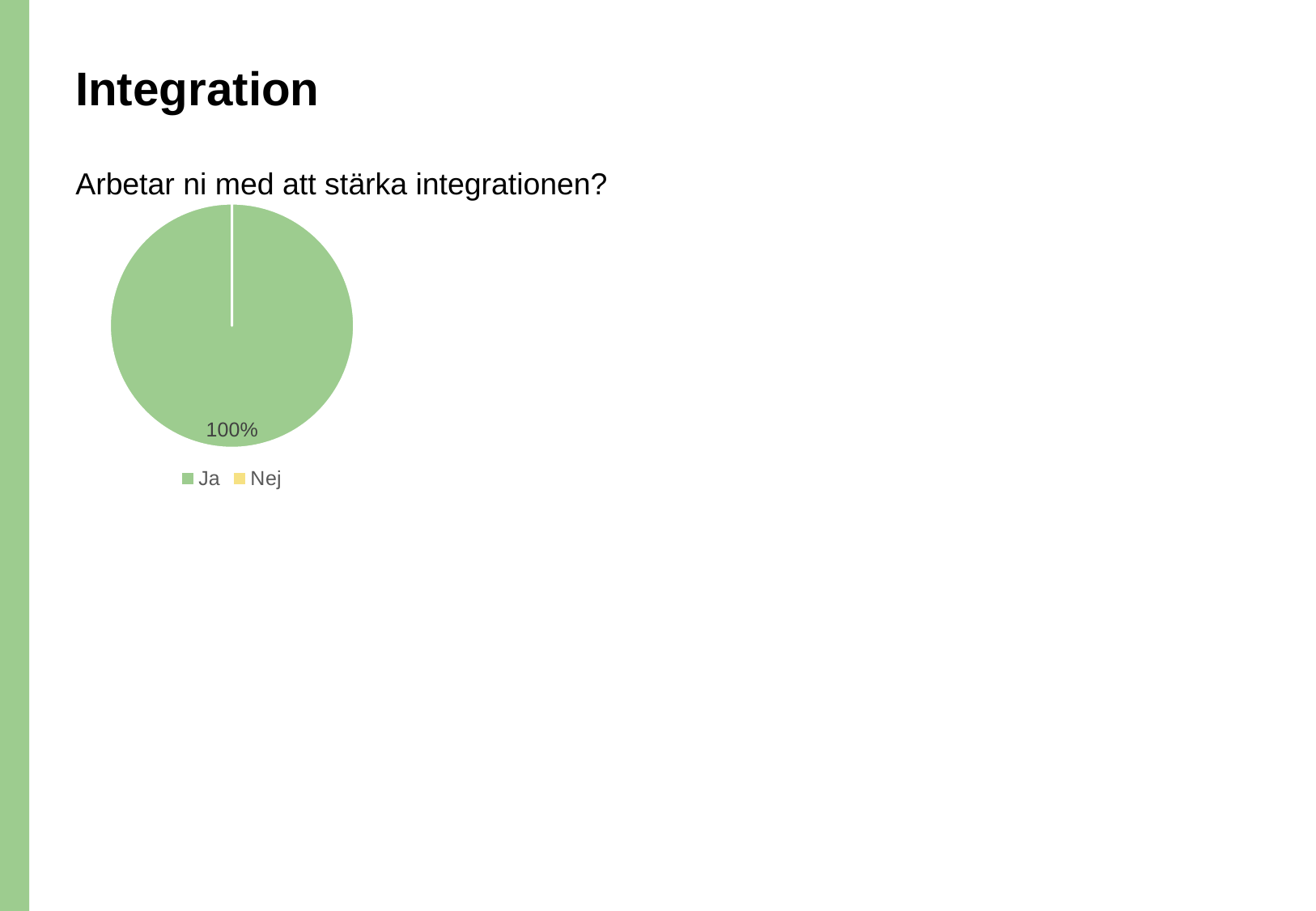
What question does the chart answer, as written above it? Arbetar ni med att stärka integrationen? Which category has the largest share of the pie? Ja What colour represents "Ja" in the legend? green Is the share for "Ja" greater or less than 50%? greater Which is larger, the share for "Ja" or the share for "Nej"? Ja What share of the pie does "Ja" represent? 100% What kind of chart is shown on the slide? pie chart What is the value printed on the pie chart? 100% How many entries does the legend list? 2